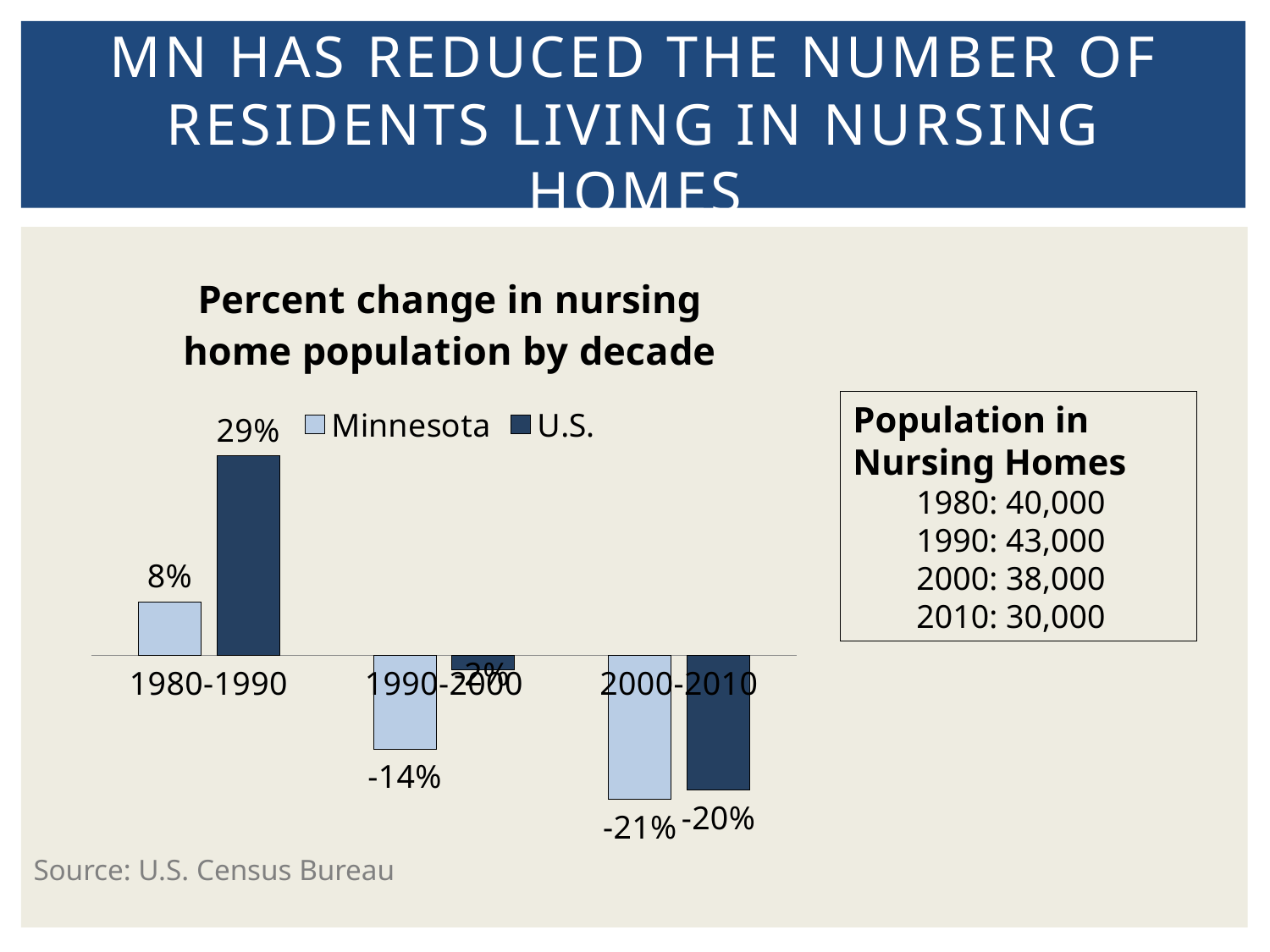
What is the percent change for the U.S. in 1980-1990? 29% What is the percent change for Minnesota in 2000-2010? -21% How many decades are shown on the x axis of the chart? 3 By how many percentage points does the U.S. value exceed the Minnesota value in 1980-1990? 21 percentage points In which decade is the Minnesota percent change the lowest? 2000-2010 What is the percent change for the U.S. in 2000-2010? -20% In which decade is the U.S. percent change the highest? 1980-1990 How many series does the chart legend list? 2 What is the percent change for Minnesota in 1990-2000? -14% In 1980-1990, which series has the larger percent change, Minnesota or U.S.? U.S. What kind of chart is shown on the slide? Bar chart What is the percent change for Minnesota in 1980-1990? 8%